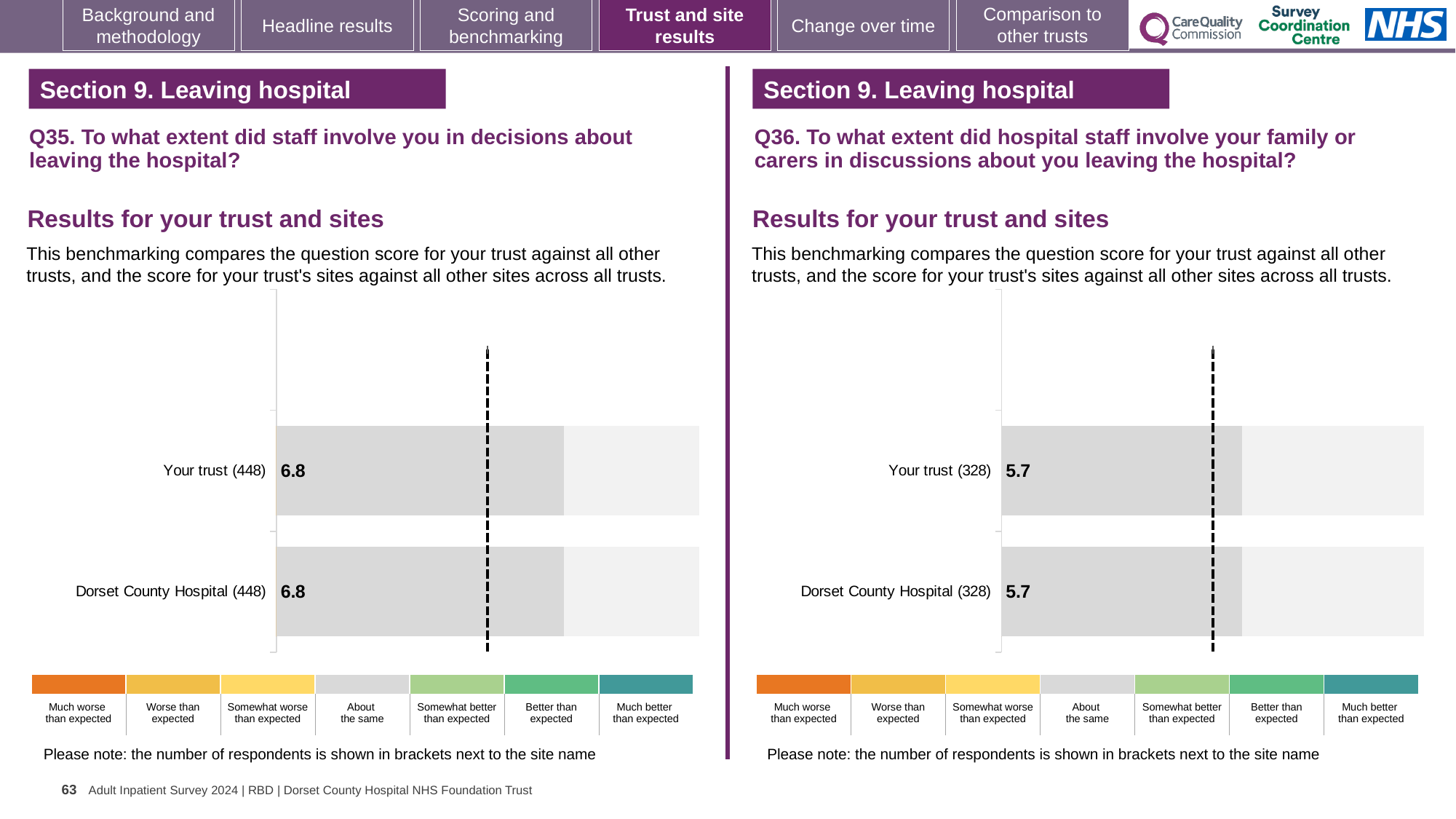
On the Q35 chart (left), how many respondents are shown in brackets next to Your trust? 448 On the Q36 chart (right), what is the score for Your trust? 5.7 How many bars are plotted on the Q35 chart (left)? 2 On the Q35 chart (left), what is the score for Your trust? 6.8 Which is larger: the Your trust score on the Q35 chart (left) or the Your trust score on the Q36 chart (right)? Q35 chart (left) What kind of chart is used on the Q35 chart (left)? Bar chart On the Q35 chart (left), what is the score for Dorset County Hospital? 6.8 How many categories does the colour key below the Q36 chart (right) list? 7 How many bars are plotted on the Q36 chart (right)? 2 What is the difference between the Your trust score on the Q35 chart (left) and the Your trust score on the Q36 chart (right)? 1.1 On the Q36 chart (right), how many respondents are shown in brackets next to Dorset County Hospital? 328 On the Q36 chart (right), what is the score for Dorset County Hospital? 5.7